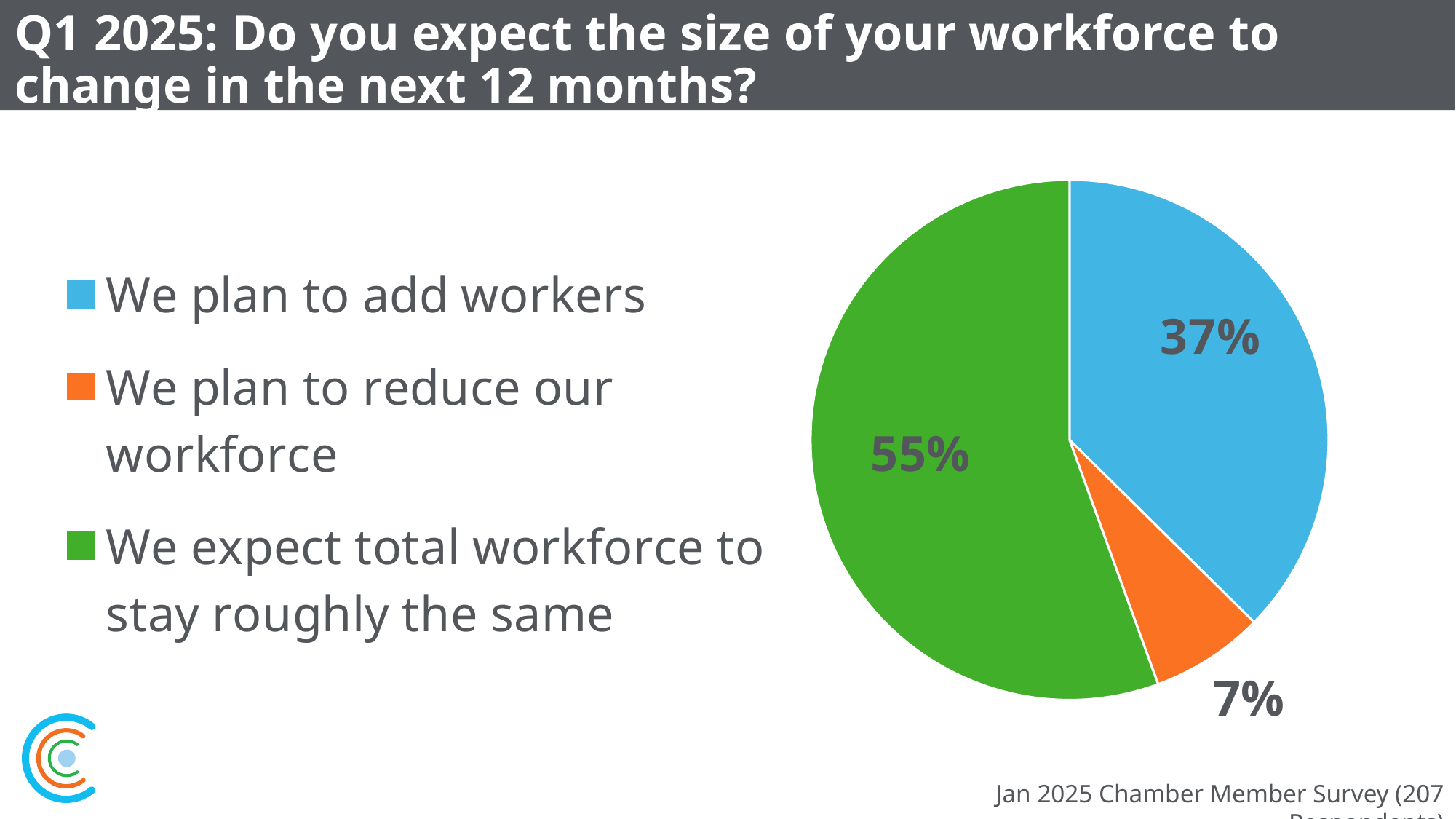
Which is larger: the share planning to add workers or the share planning to reduce their workforce? We plan to add workers What percentage of respondents plan to add workers? 37% How many slices does the pie chart have? 3 Which response has the smallest share of the pie? We plan to reduce our workforce What percentage of respondents expect total workforce to stay roughly the same? 55% What colour is the slice for 'We plan to reduce our workforce'? Orange What percentage of respondents plan to reduce their workforce? 7% What is the difference in percentage points between those who plan to add workers and those who plan to reduce their workforce? 30 What kind of chart is shown on the slide? Pie chart What is the difference in percentage points between those who expect workforce to stay roughly the same and those who plan to add workers? 18 Which response has the largest share of the pie? We expect total workforce to stay roughly the same How many respondents does the survey source note cite? 207